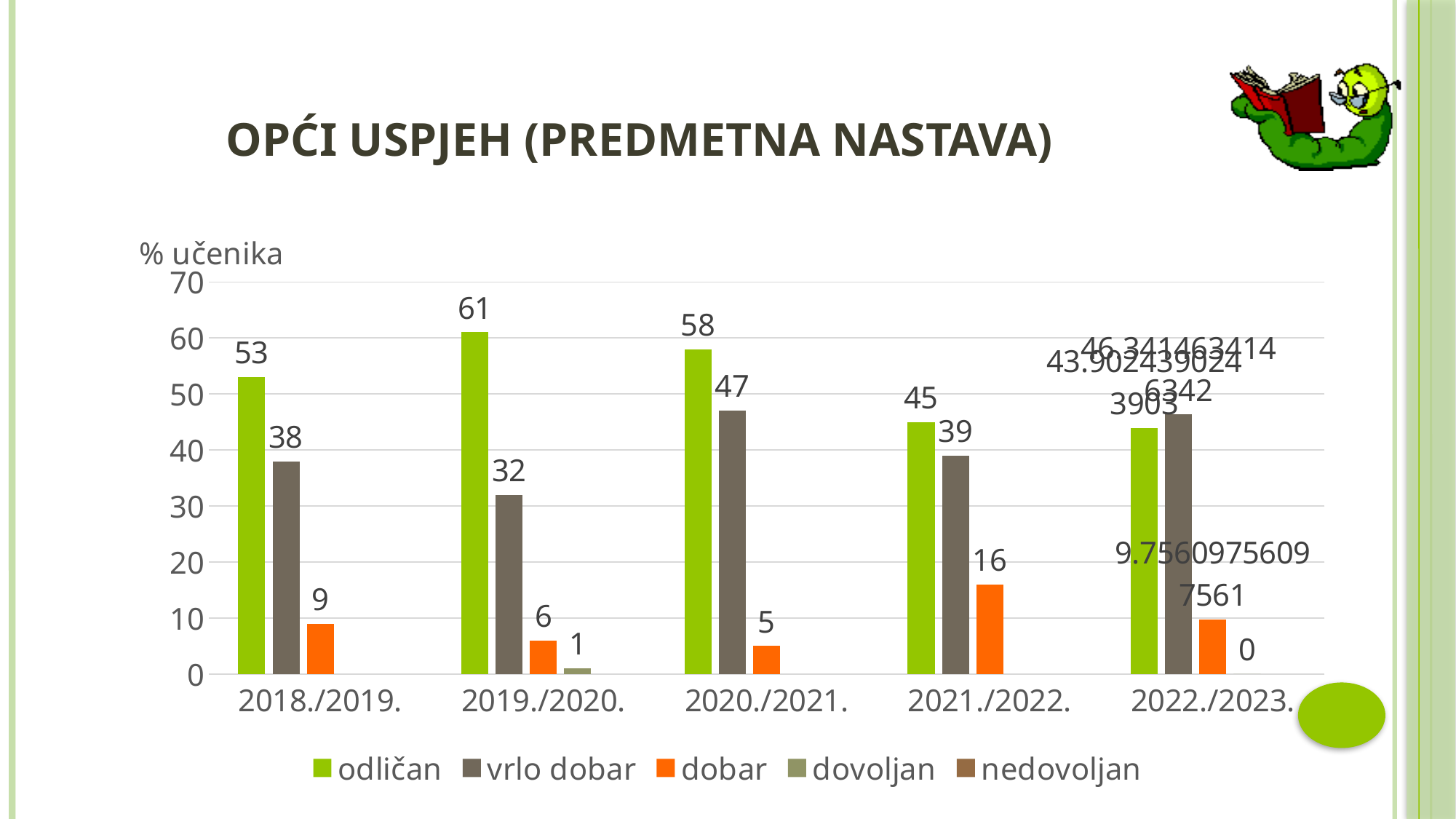
Which is larger in 2021./2022., odličan or vrlo dobar? odličan What is the difference between odličan and vrlo dobar in 2018./2019.? 15 What is the value for vrlo dobar in 2020./2021.? 47 What is the value for dobar in 2021./2022.? 16 Is the value for vrlo dobar in 2022./2023. greater or less than 40? greater In which school year is the value for dobar lowest among the years with printed whole-number labels (2018./2019. to 2021./2022.)? 2020./2021. What type of chart is shown on the slide? bar chart How many school years are shown on the x axis? 5 What is the value for dovoljan in 2019./2020.? 1 What is the value for odličan in 2019./2020.? 61 In which school year is the value for odličan highest? 2019./2020. How many series does the legend list? 5